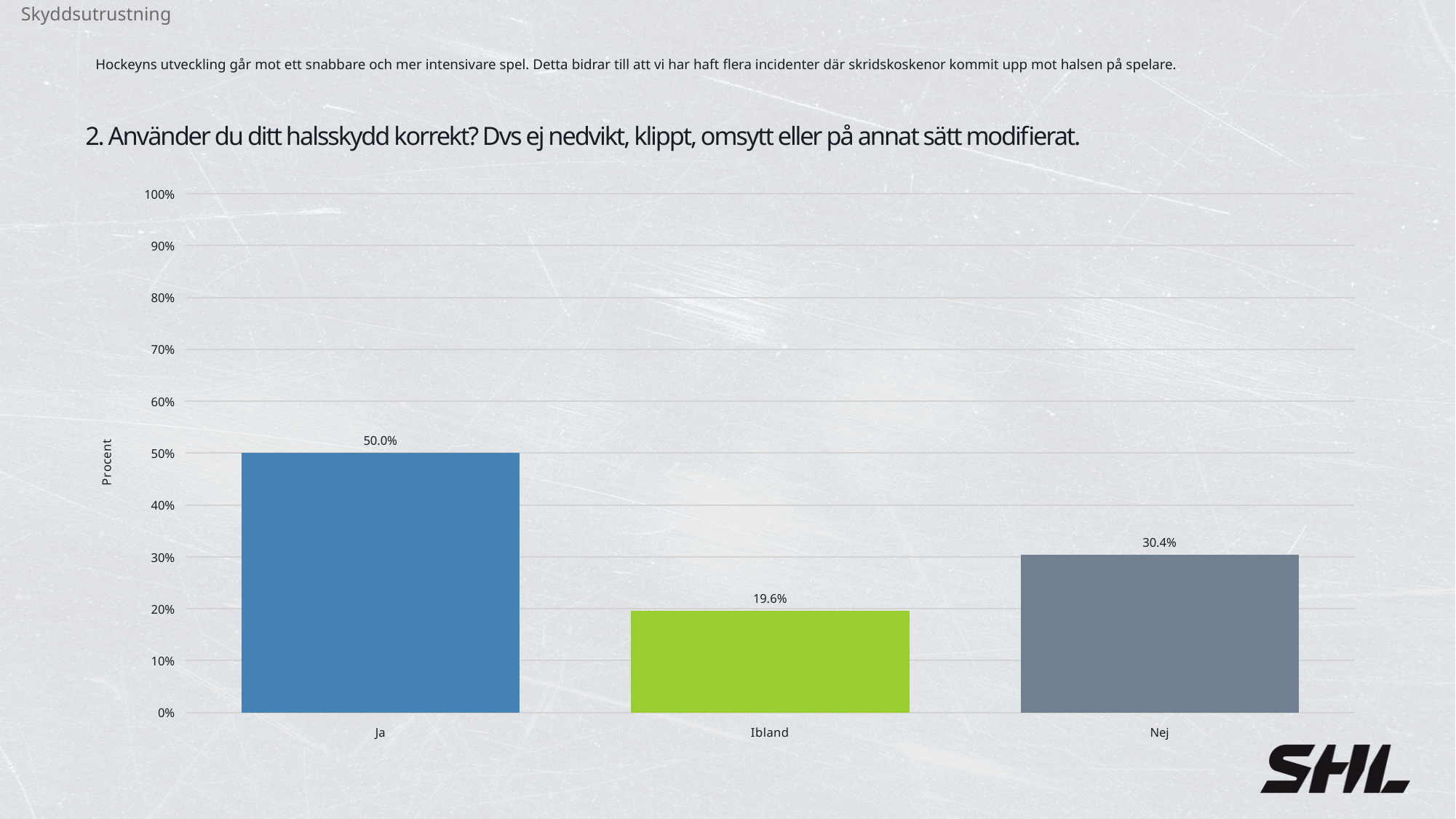
Which category has the lowest value? Ibland What is the value for Nej? 30.4% Which category has the highest value? Ja What is the difference between the values for Nej and Ibland? 10.8% Is the value for Nej greater or less than 40%? less What is the value for Ja? 50.0% What kind of chart is shown on the slide? bar chart What is the difference between the values for Ja and Nej? 19.6% Which is larger, the value for Ibland or the value for Nej? Nej What is the value for Ibland? 19.6% How many categories are shown on the x axis? 3 What is the label of the y axis? Procent